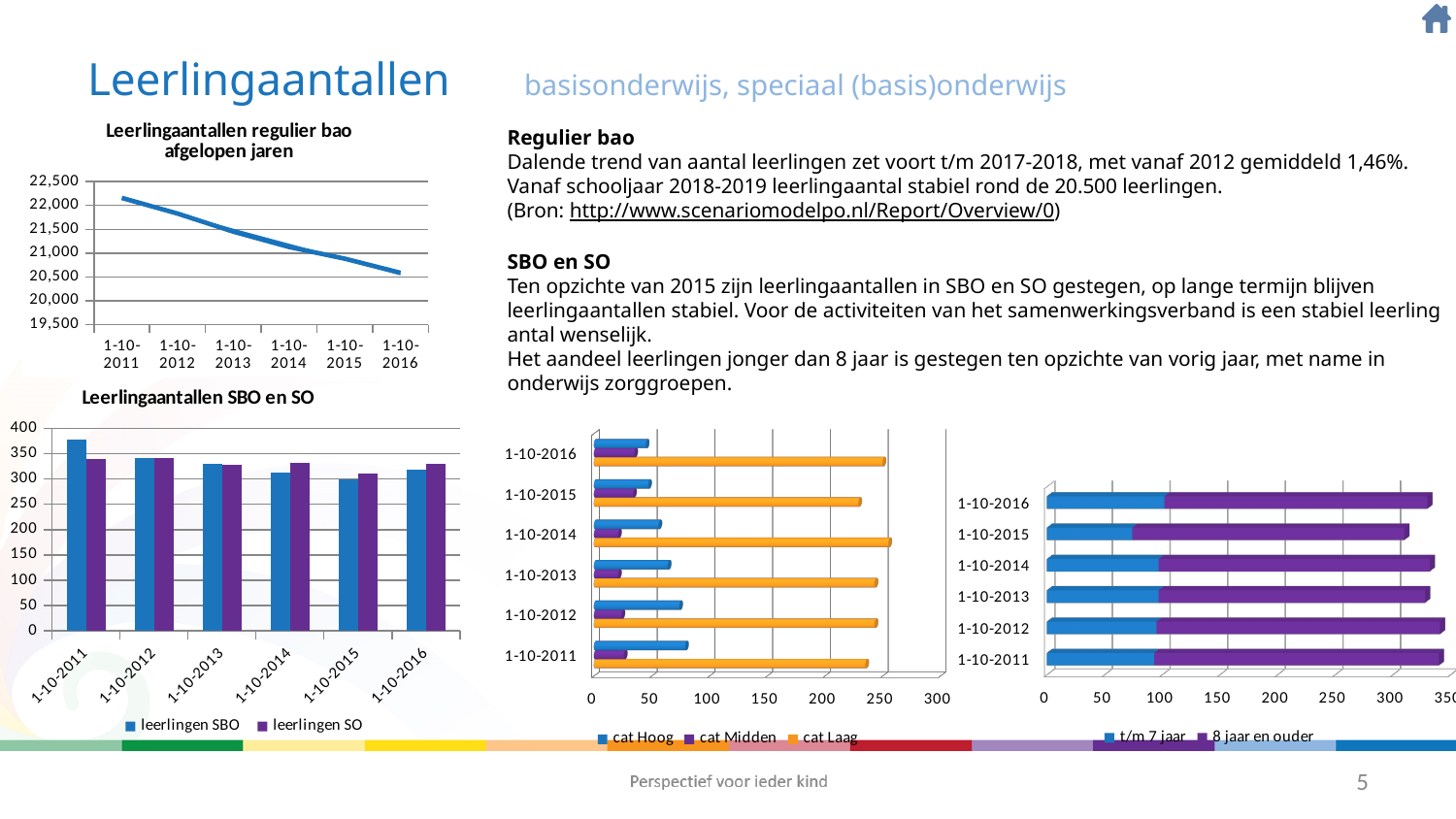
How many series does the legend of the stacked bar chart at the bottom right list? 2 In the chart 'Leerlingaantallen regulier bao afgelopen jaren', do the values rise or fall from 1-10-2011 to 1-10-2016? fall In the horizontal bar chart at the bottom centre, is the value for cat Hoog at 1-10-2011 greater or less than 50? greater How many data points are plotted in the chart 'Leerlingaantallen regulier bao afgelopen jaren'? 6 What kind of chart is 'Leerlingaantallen SBO en SO'? bar chart In the horizontal bar chart at the bottom centre with categories cat Hoog, cat Midden and cat Laag, which series has the highest value at 1-10-2016? cat Laag In the chart 'Leerlingaantallen regulier bao afgelopen jaren', is the value for 1-10-2016 greater or less than 21,000? less In the chart 'Leerlingaantallen SBO en SO', which is larger at 1-10-2011: leerlingen SBO or leerlingen SO? leerlingen SBO In the chart 'Leerlingaantallen SBO en SO', is the value for leerlingen SBO at 1-10-2011 greater or less than 350? greater What kind of chart is 'Leerlingaantallen regulier bao afgelopen jaren'? line chart How many series does the legend of the chart 'Leerlingaantallen SBO en SO' list? 2 In the chart 'Leerlingaantallen SBO en SO', which year has the highest value for leerlingen SBO? 1-10-2011